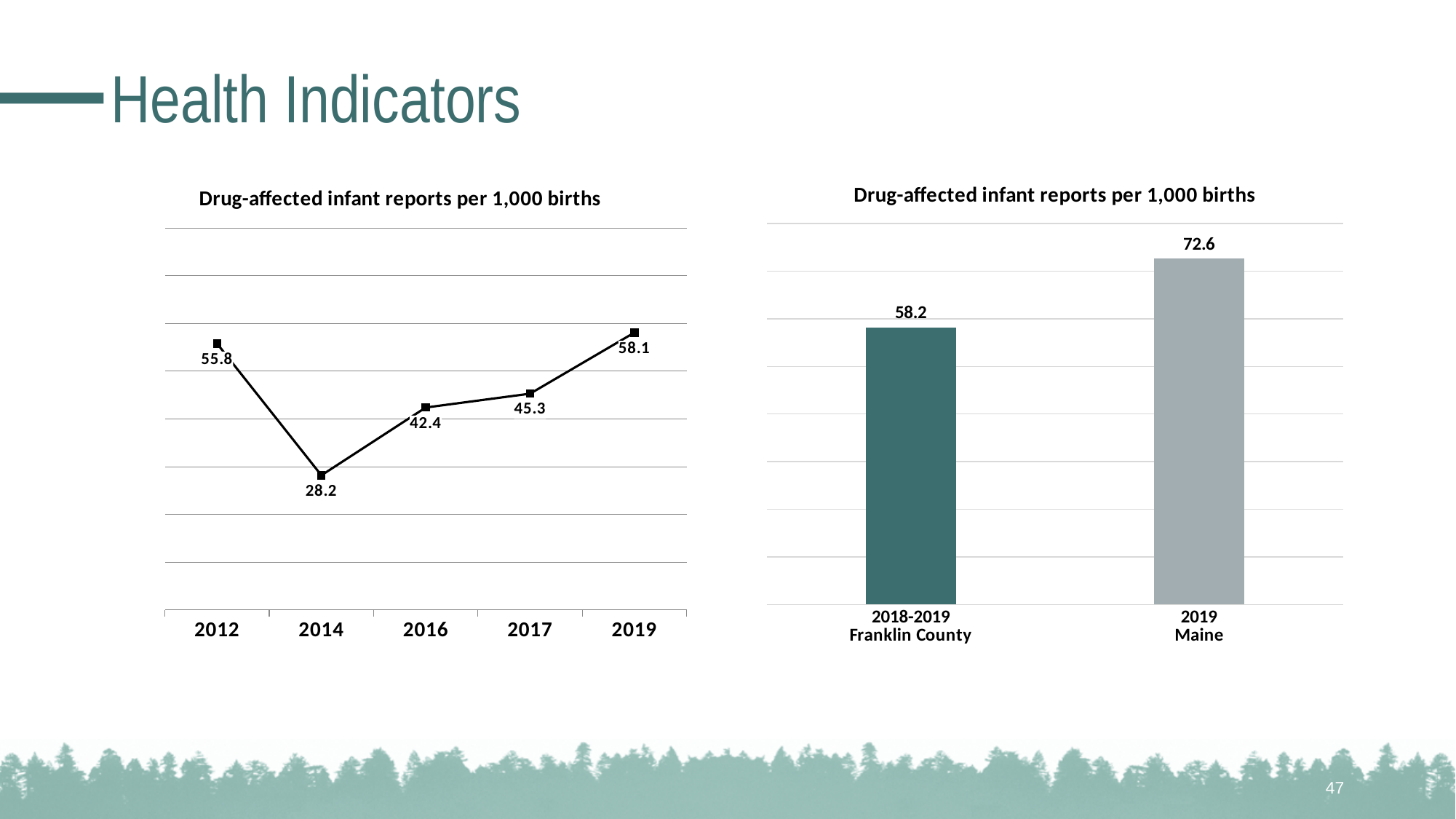
In the right chart, what is the difference between the Maine value and the Franklin County value? 14.4 What kind of chart is the left chart? Line chart What kind of chart is the right chart? Bar chart In the left chart, which year has the highest value? 2019 In the left chart, what is the difference between the 2012 and 2014 values? 27.6 In the left chart, what is the value for 2014? 28.2 In the left chart, how many years are plotted? 5 In the left chart, is the value for 2017 larger than the value for 2016? Yes In the left chart, which year has the lowest value? 2014 In the left chart, do the values rise or fall from 2014 to 2019? Rise In the right chart, what is the value for Maine in 2019? 72.6 In the left chart, what is the value for 2019? 58.1